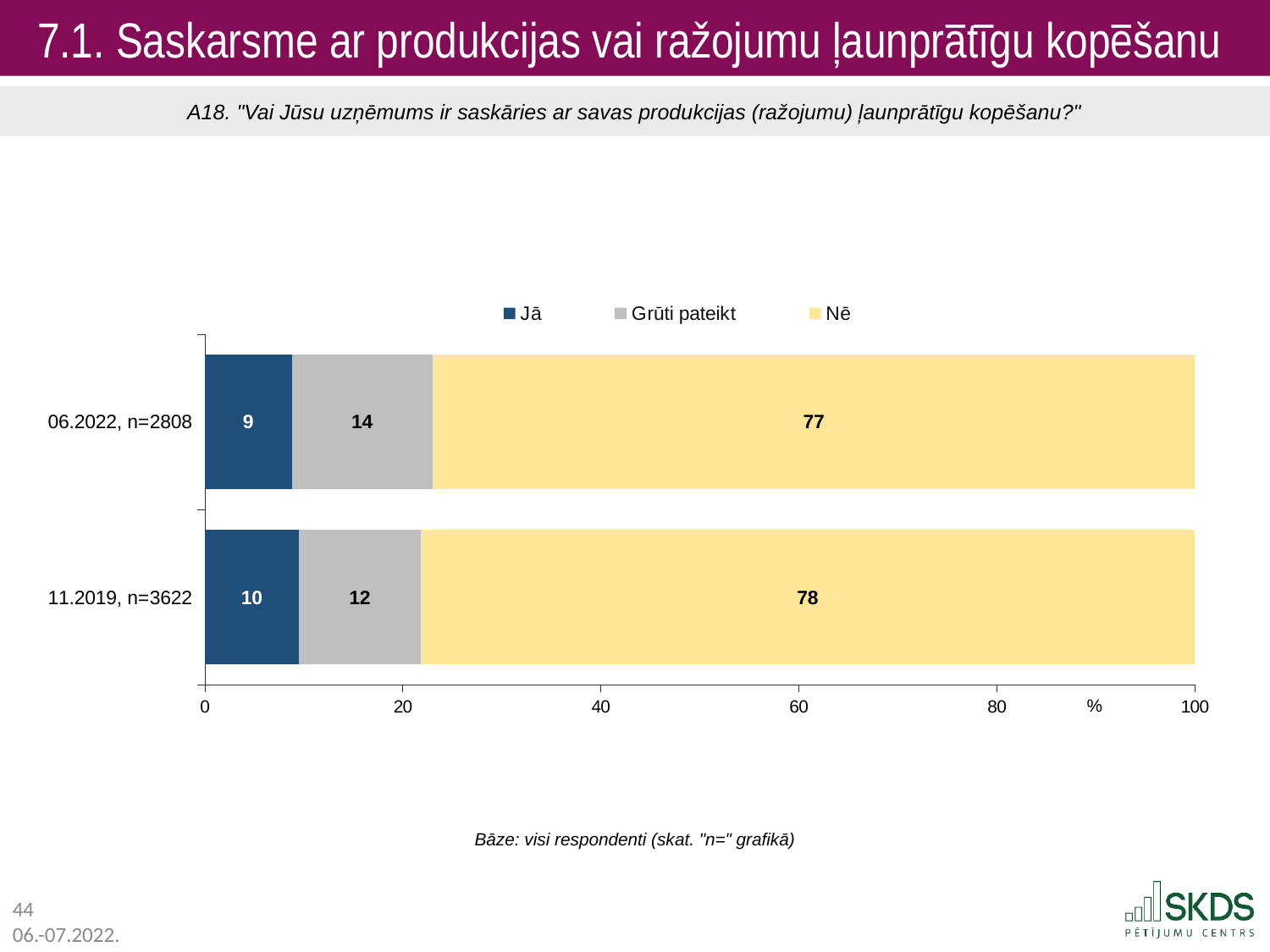
How many series does the legend list? 3 What is the value for "Jā" in the 06.2022, n=2808 bar? 9 What is the value for "Jā" in the 11.2019, n=3622 bar? 10 Which series has the highest value in the 06.2022, n=2808 bar? Nē What is the difference between the "Grūti pateikt" values for 06.2022, n=2808 and 11.2019, n=3622? 2 What kind of chart is shown on the slide? Stacked bar chart Which series has the lowest value in the 11.2019, n=3622 bar? Jā What is the value for "Grūti pateikt" in the 06.2022, n=2808 bar? 14 What is the value for "Nē" in the 11.2019, n=3622 bar? 78 What is the total of the stacked bar for 06.2022, n=2808? 100 How many categories (bars) are shown on the chart? 2 Which is larger: the "Nē" value for 06.2022, n=2808 or for 11.2019, n=3622? 11.2019, n=3622